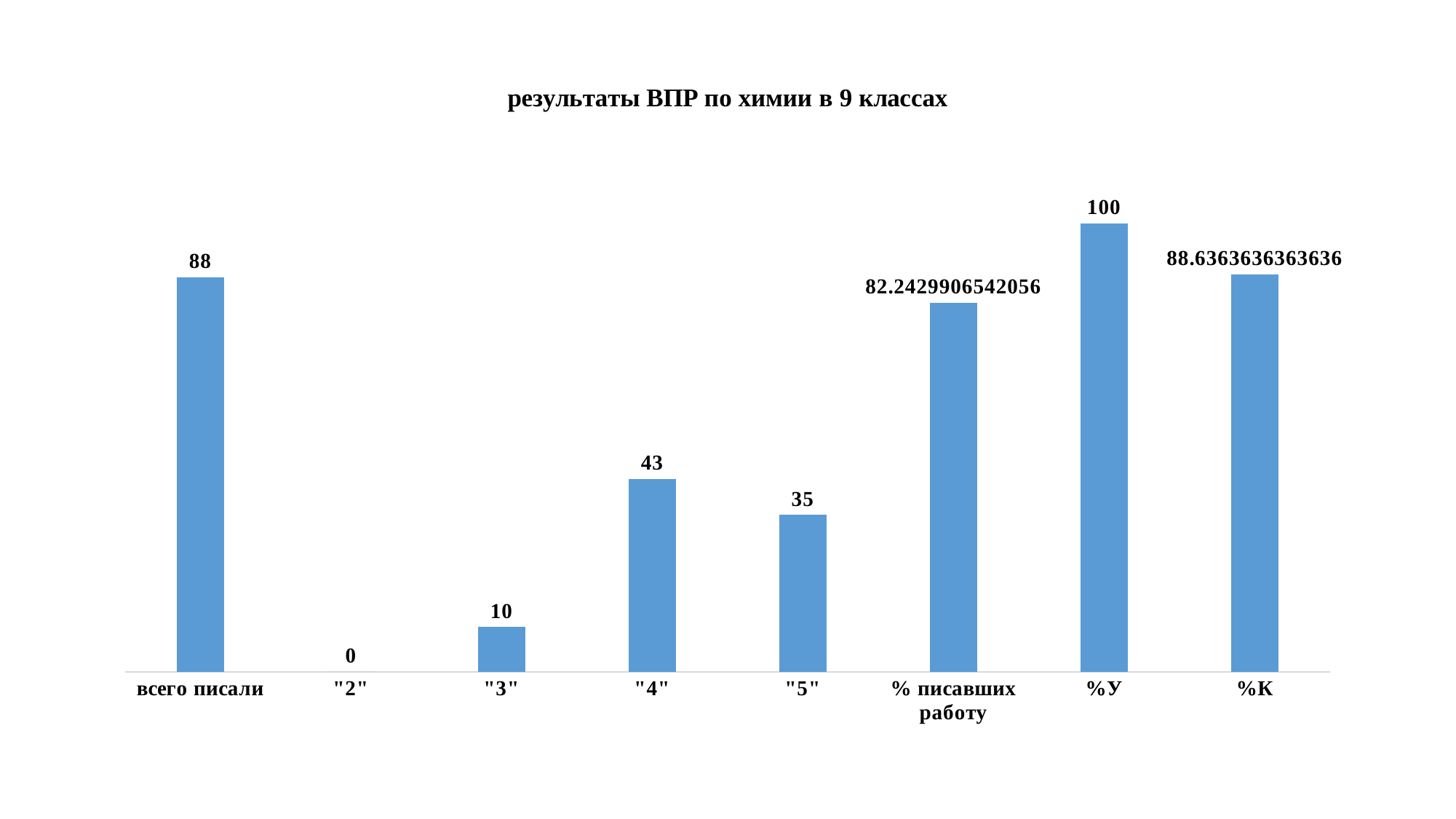
What is the value for "всего писали"? 88 What is the difference between the values for "4" and "5"? 8 What is the value for "%К"? 88.6363636363636 Which category has the lowest value? "2" What is the title of the chart? результаты ВПР по химии в 9 классах Which category has the highest value? %У Which is larger, the value for "3" or the value for "5"? "5" How many categories are shown on the x axis? 8 What is the value for "% писавших работу"? 82.2429906542056 What is the value for "4"? 43 What is the difference between the values for "всего писали" and "3"? 78 What kind of chart is this? bar chart